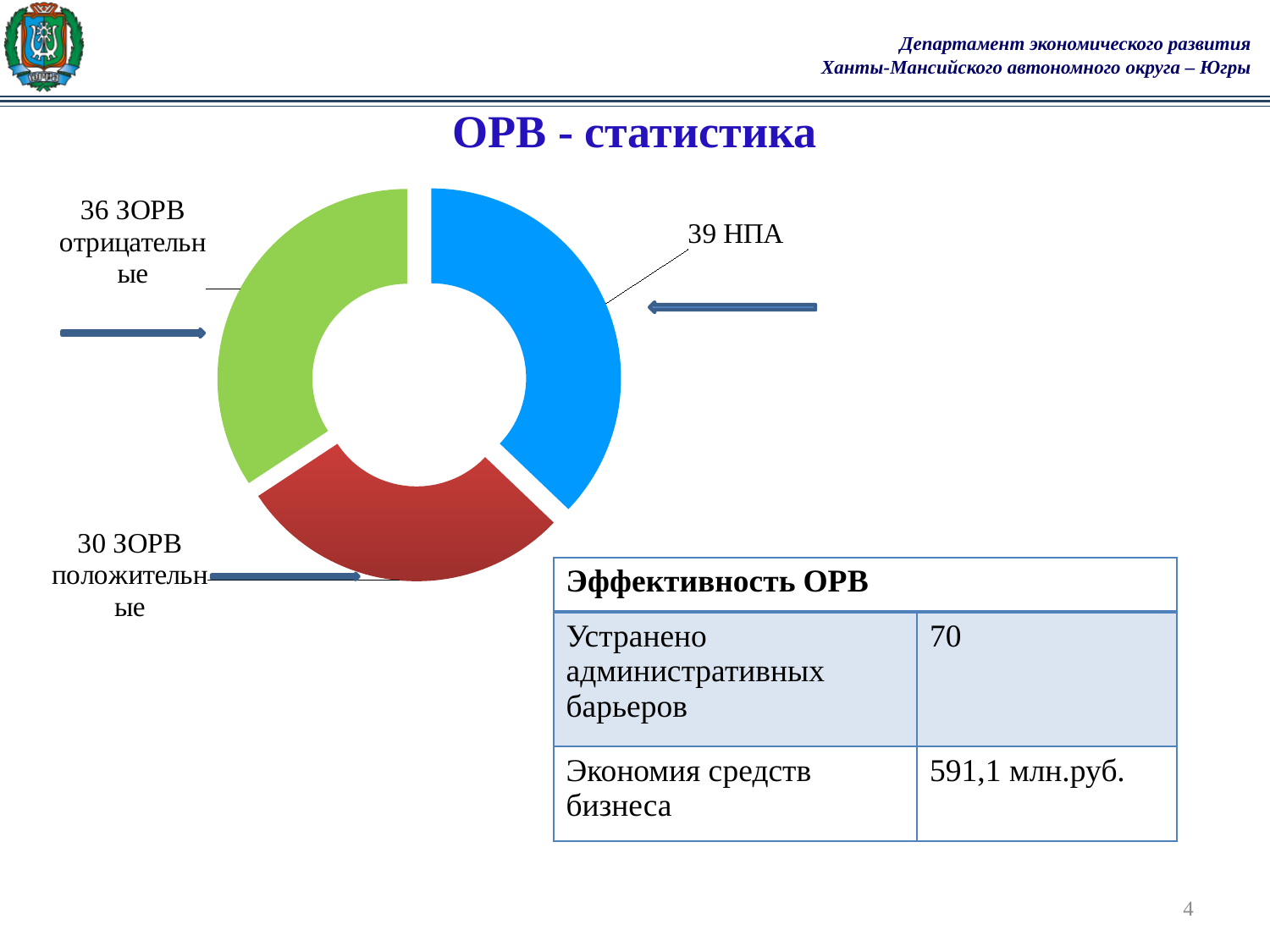
What value is shown for the НПА segment? 39 НПА How many ЗОРВ положительные are shown on the chart? 30 What kind of chart is shown on the slide? Doughnut (pie) chart What is the difference between the number of ЗОРВ отрицательные and ЗОРВ положительные? 6 Which segment of the chart has the smallest value? 30 ЗОРВ положительные How many segments does the doughnut chart have? 3 What colour is the segment representing 39 НПА? Blue Which segment of the chart has the largest value? 39 НПА Which is larger: the number of НПА or the number of ЗОРВ отрицательные? НПА (39) What is the title of the slide containing the chart? ОРВ - статистика How many ЗОРВ отрицательные are shown on the chart? 36 What is the total of all three segments in the chart? 105